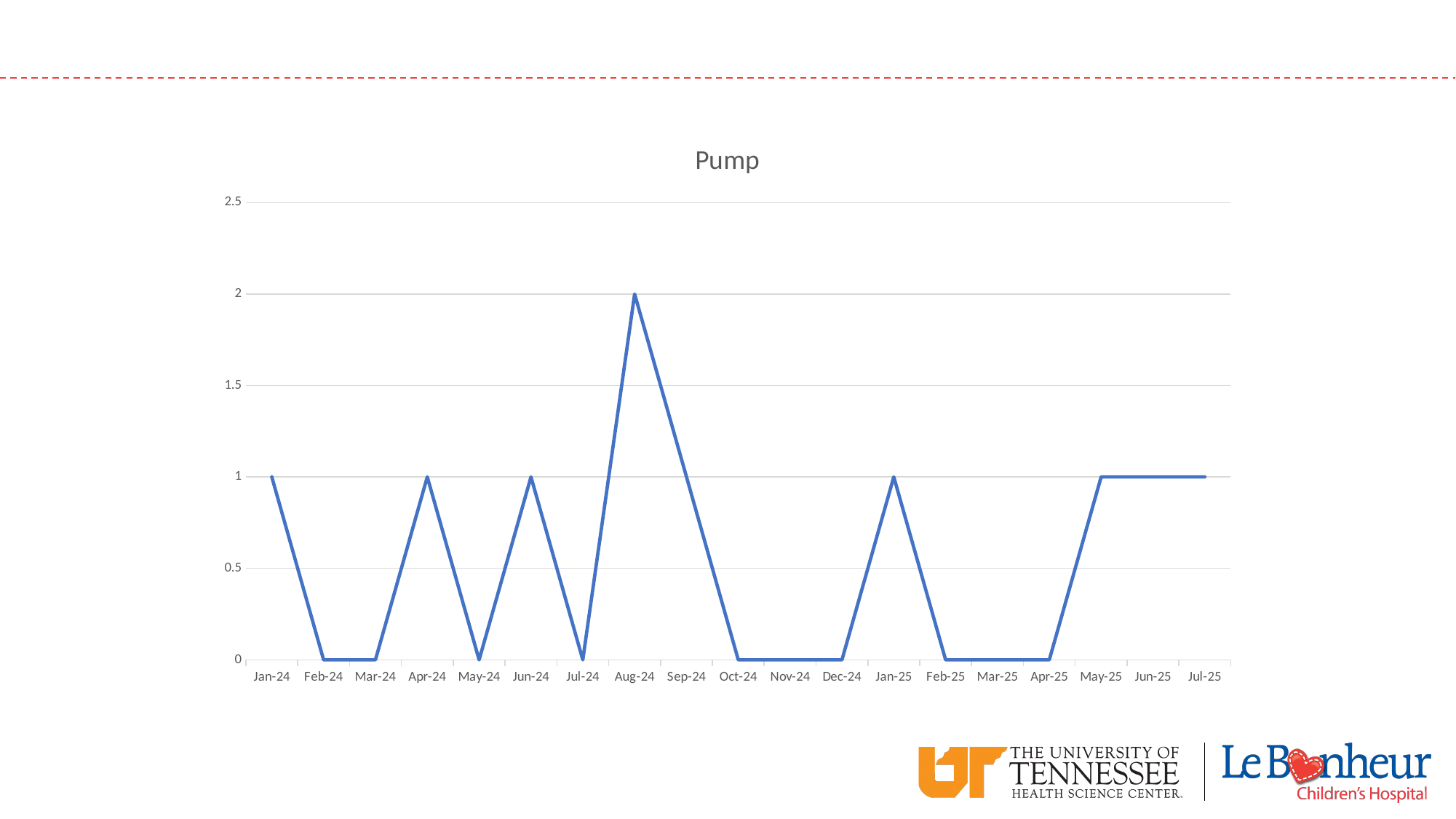
Does the value rise or fall from Apr-25 to May-25? rise What is the value for Aug-24? 2 What kind of chart is shown on the slide? line chart Is the value for Aug-24 greater or less than 1.5? greater What is the value for Jan-24? 1 Which month has the highest value? Aug-24 What is the value for Jul-25? 1 What is the difference between the values for Aug-24 and Sep-24? 1 What is the title of the chart? Pump Which is larger, the value for Jun-24 or the value for Jul-24? Jun-24 How many months are plotted on the x axis? 19 What is the value for Nov-24? 0